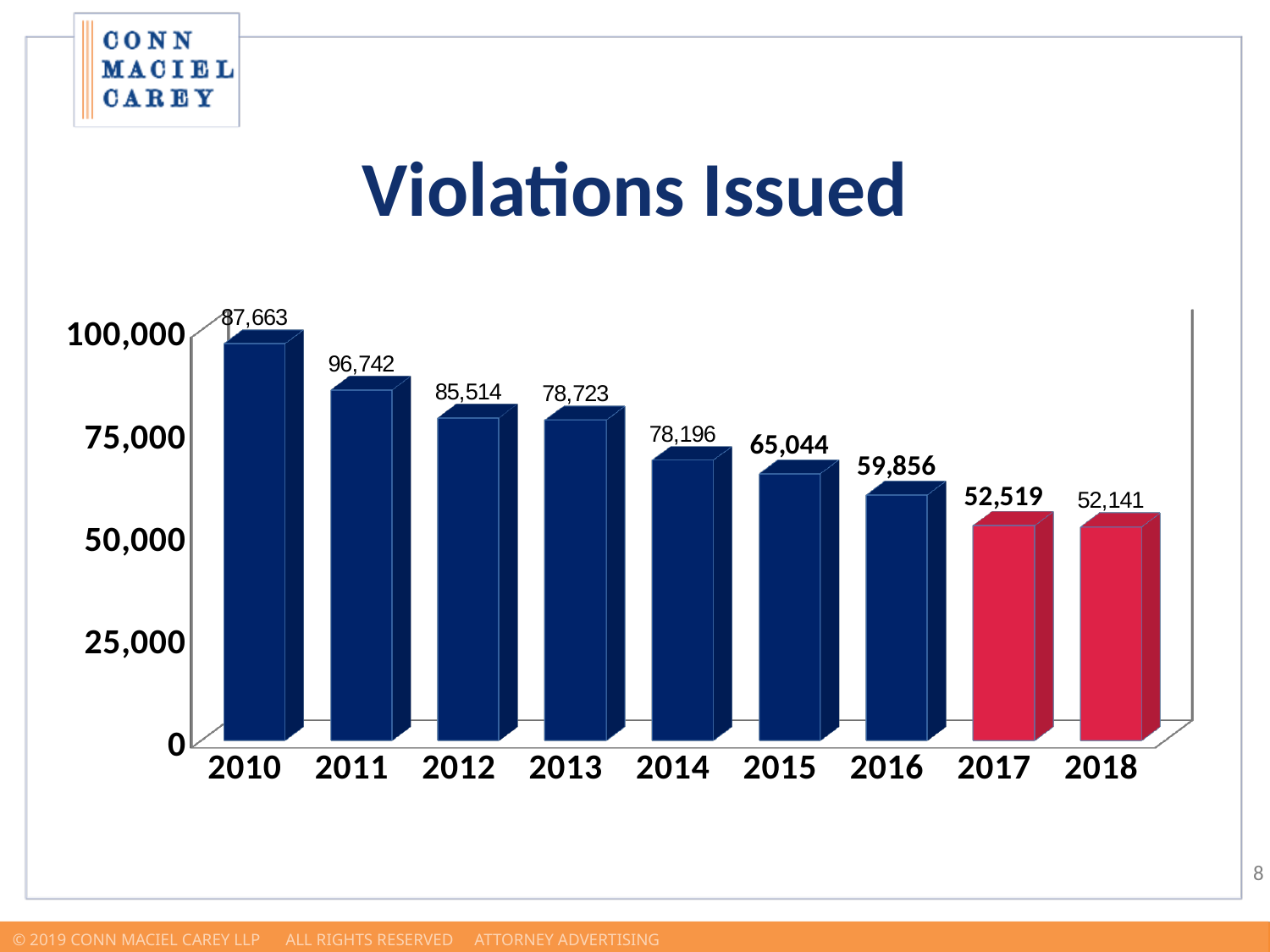
How many violations were issued in 2016 according to the chart? 59,856 What is the value for 2013 in the Violations Issued chart? 78,723 Which year has the lowest value in the chart? 2018 How many years are shown on the x axis of the chart? 9 What kind of chart is shown on the slide? bar chart Which is larger, the value for 2015 or the value for 2016? 2015 What value is shown for 2018? 52,141 What is the difference between the values for 2016 and 2017? 7,337 What is the value labelled for 2011? 96,742 Is the value for 2016 greater or less than 75,000? less What colour are the bars for 2017 and 2018? red What is the difference between the values for 2014 and 2015? 13,152